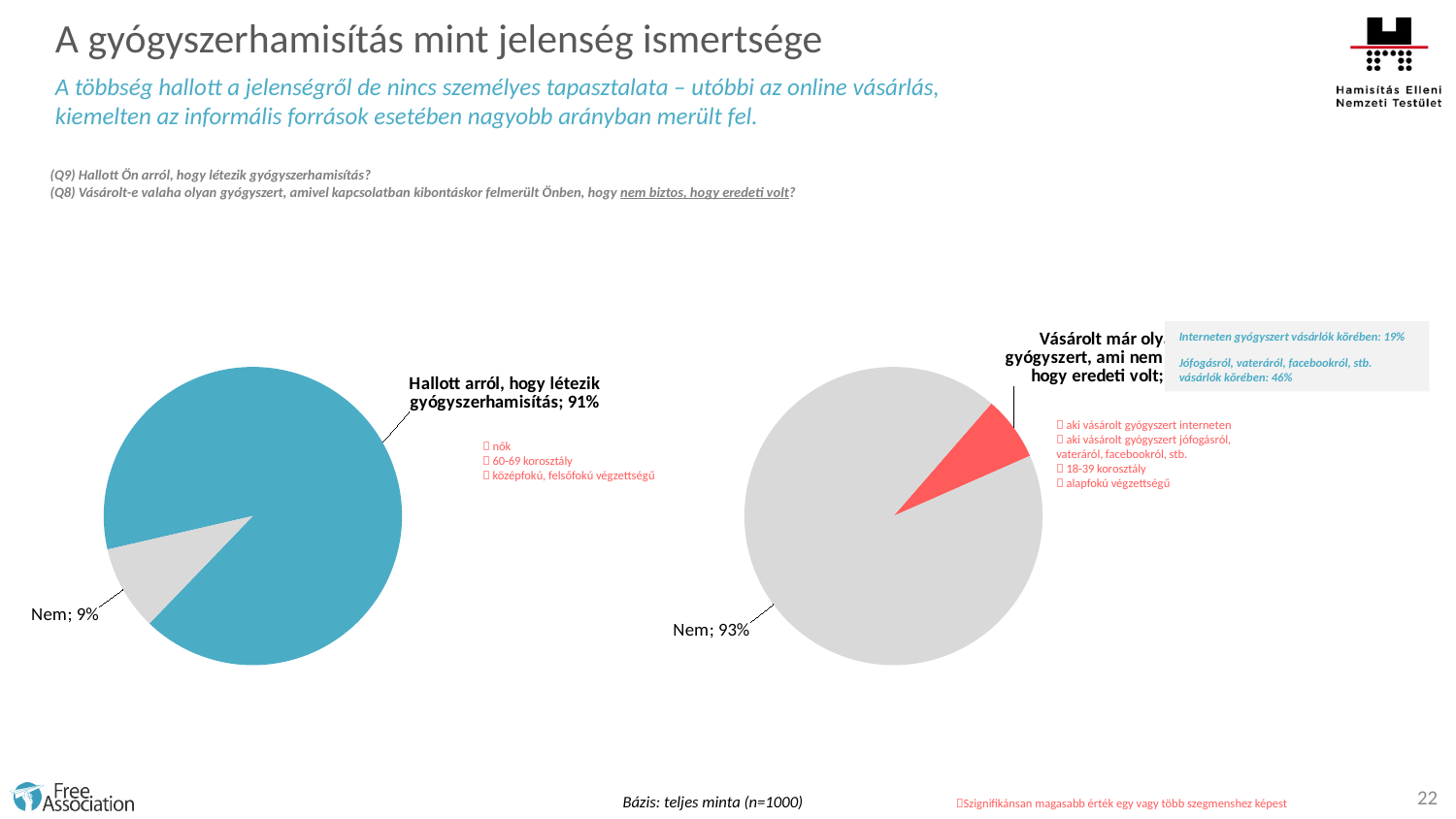
How many slices does the left pie chart have? 2 In the left pie chart, what share is labelled 'Nem'? 9% In the right pie chart, which slice is the largest? Nem In the left pie chart, what share is labelled 'Hallott arról, hogy létezik gyógyszerhamisítás'? 91% In the left pie chart, which slice is the largest? Hallott arról, hogy létezik gyógyszerhamisítás In the left pie chart, which is larger: the 'Hallott arról, hogy létezik gyógyszerhamisítás' slice or the 'Nem' slice? Hallott arról, hogy létezik gyógyszerhamisítás What kind of chart is the left chart on the slide? pie chart In the right pie chart, what colour is the 'Nem' slice? grey In the left pie chart, which slice is the smallest? Nem What kind of chart is the right chart on the slide? pie chart In the right pie chart, what share is labelled 'Nem'? 93% In the left pie chart, what is the difference in percentage points between the 'Hallott arról, hogy létezik gyógyszerhamisítás' slice and the 'Nem' slice? 82 percentage points